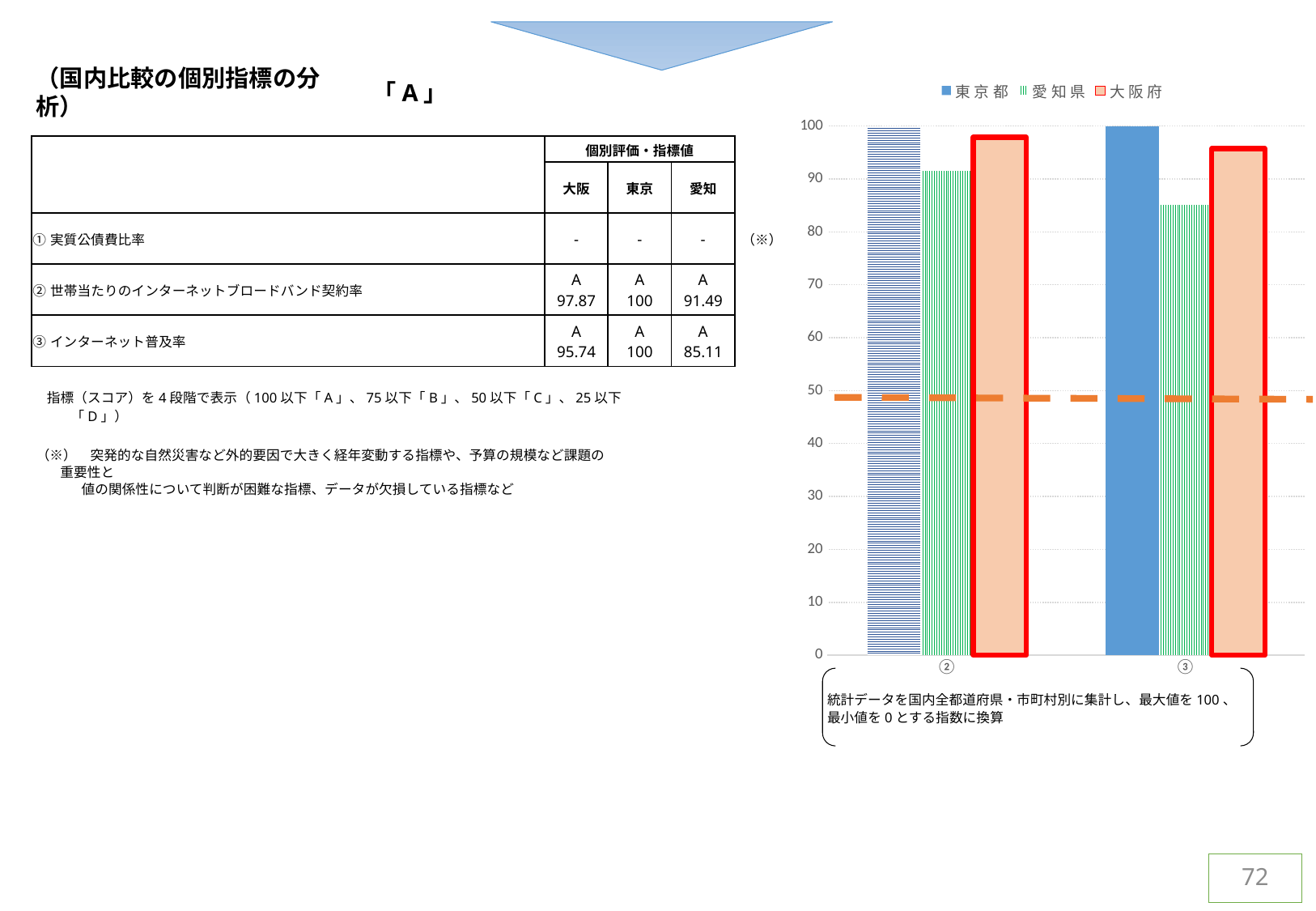
What is the value for 東京都 in category ③? 100 How many series does the legend of the chart list? 3 What kind of chart is shown on the right side of the slide? bar chart Which series has the lowest value in category ②? 愛知県 Which series' bars are outlined in red on the chart? 大阪府 Is the value for 愛知県 in category ③ greater or less than 90? less Is the value for 大阪府 in category ③ greater or less than 90? greater In category ③, which is larger: the value for 大阪府 or the value for 愛知県? 大阪府 Which series has the lowest value in category ③? 愛知県 How many categories are shown on the x axis of the chart? 2 Is the value for 愛知県 in category ② greater or less than 80? greater What is the value for 東京都 in category ②? 100